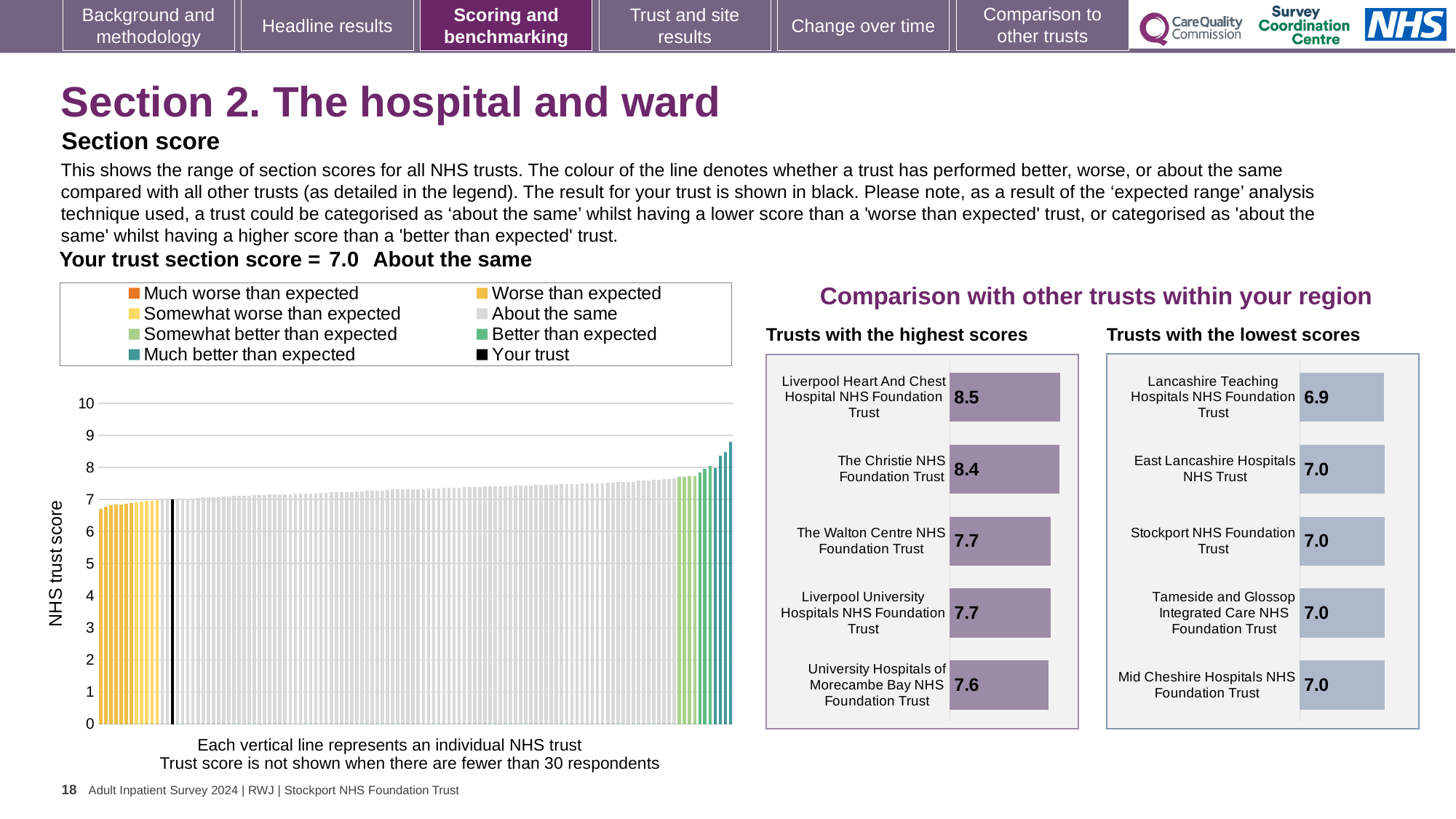
How many trusts are shown in the 'Trusts with the highest scores' chart? 5 How many entries does the legend of the NHS trust score chart on the left list? 8 What kind of chart is the NHS trust score chart on the left of the slide? Bar chart In the 'Trusts with the highest scores' chart, which trust has the highest score? Liverpool Heart And Chest Hospital NHS Foundation Trust In the 'Trusts with the highest scores' chart, what is the score for Liverpool Heart And Chest Hospital NHS Foundation Trust? 8.5 In the NHS trust score chart on the left, do the values rise or fall from left to right? Rise In the 'Trusts with the highest scores' chart, which has the larger score: The Walton Centre NHS Foundation Trust or The Christie NHS Foundation Trust? The Christie NHS Foundation Trust In the 'Trusts with the highest scores' chart, what is the difference between the scores of Liverpool Heart And Chest Hospital NHS Foundation Trust and University Hospitals of Morecambe Bay NHS Foundation Trust? 0.9 In the 'Trusts with the lowest scores' chart, which trust has the lowest score? Lancashire Teaching Hospitals NHS Foundation Trust In the 'Trusts with the lowest scores' chart, what is the score for Stockport NHS Foundation Trust? 7.0 In the 'Trusts with the highest scores' chart, what is the score for The Christie NHS Foundation Trust? 8.4 In the NHS trust score chart on the left, is the value of the tallest bar greater or less than 8? greater